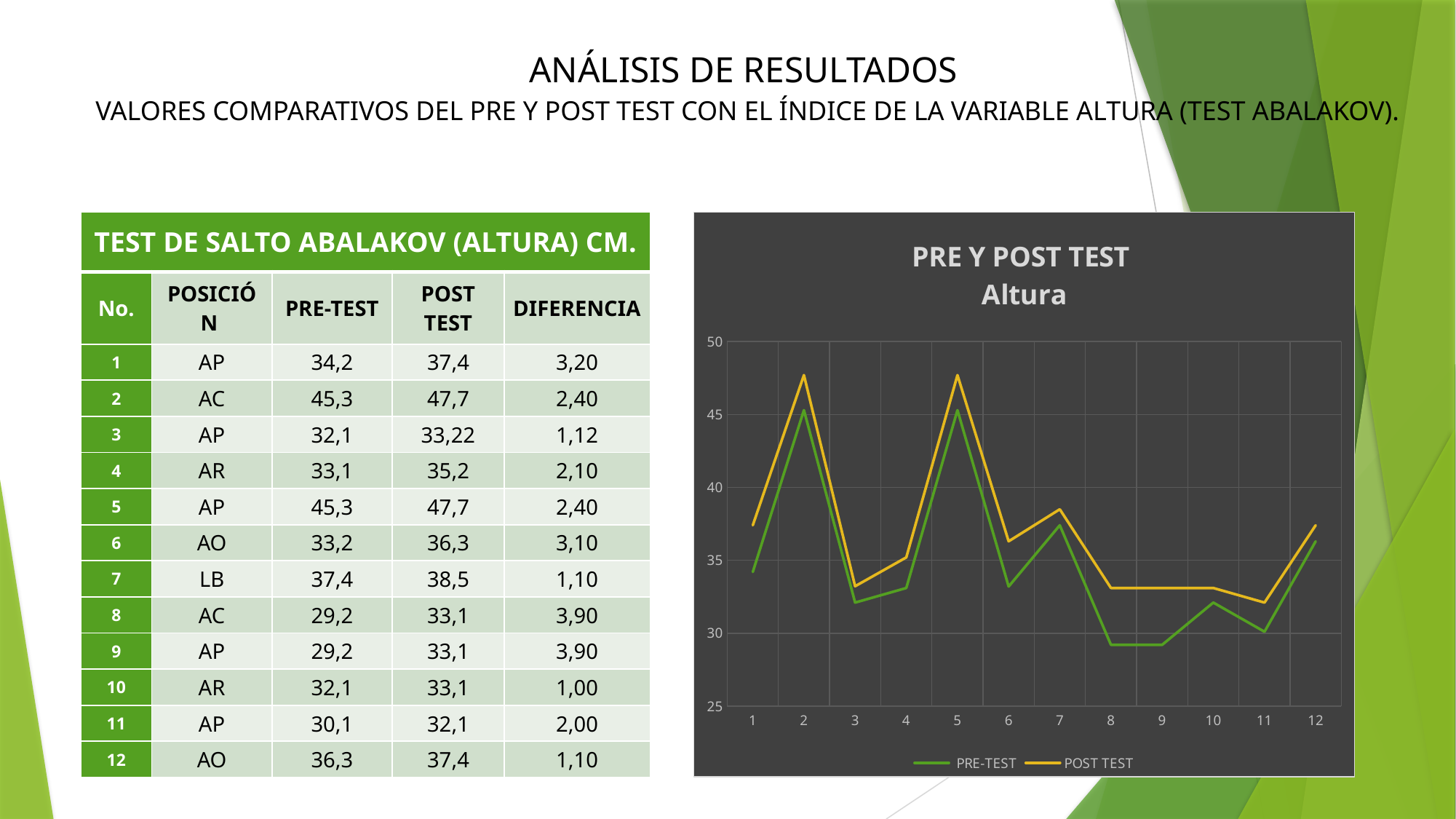
What is the difference between the POST TEST and PRE-TEST values at point 8, as given in the table? 3,90 At point 7, which series has the higher value, PRE-TEST or POST TEST? POST TEST How many series does the chart legend list? 2 Which series is drawn in green in the chart? PRE-TEST What is the title of the chart? PRE Y POST TEST Altura What is the PRE-TEST value at point 1, as given in the table on the slide? 34,2 Is the POST TEST value at point 2 greater or less than 45? greater At which point does the POST TEST series reach its lowest value? 11 How many points are plotted along the x axis of the chart? 12 What kind of chart is shown on the slide? line chart Does the PRE-TEST line rise or fall from point 5 to point 6? fall Is the PRE-TEST value at point 8 greater or less than 30? less